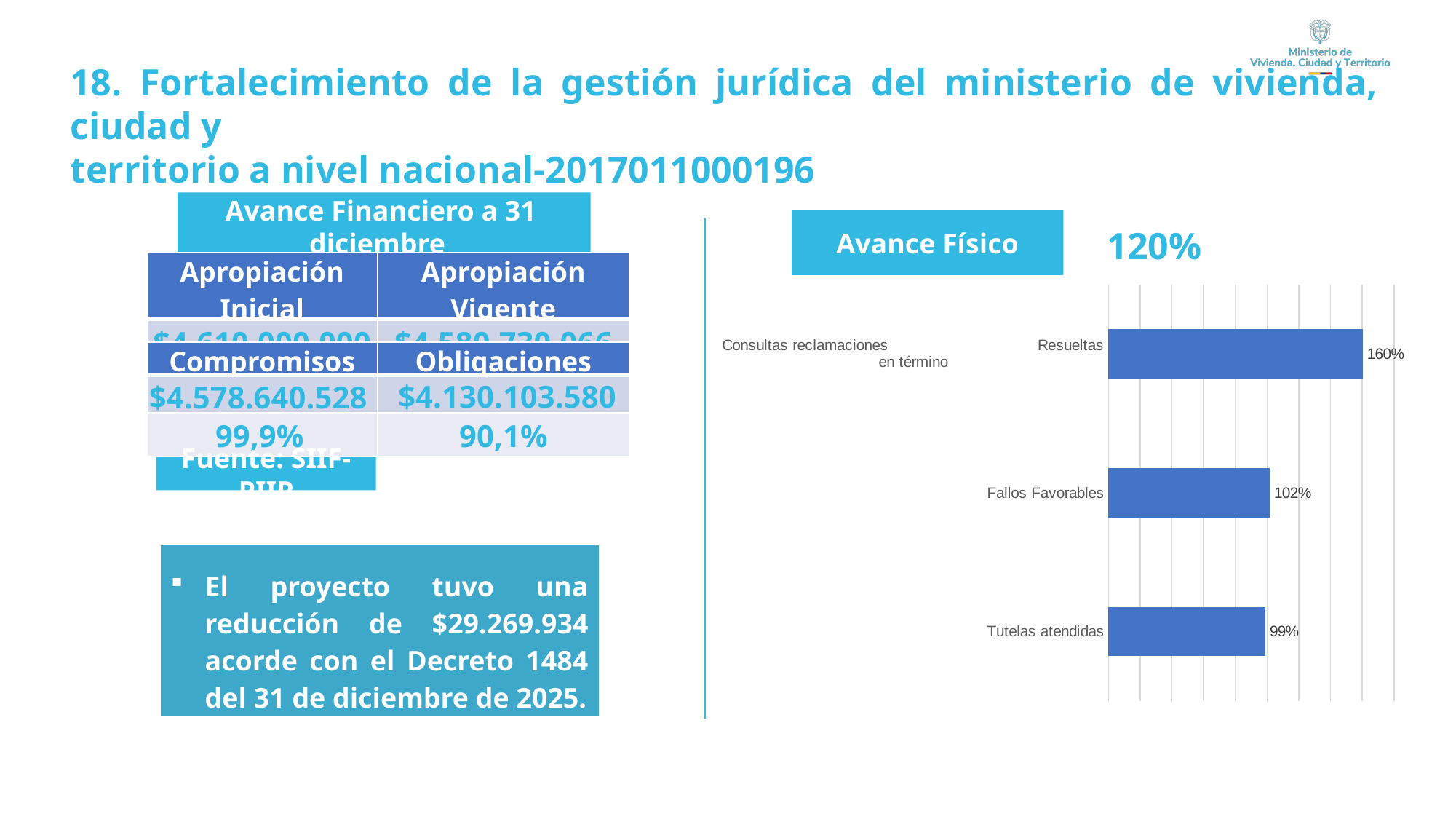
In the "Avance Físico" chart, what is the difference between the values for "Fallos Favorables" and "Tutelas atendidas"? 3% What is the value for "Tutelas atendidas" in the "Avance Físico" chart? 99% What kind of chart is shown under "Avance Físico"? bar chart In the "Avance Físico" chart, which is larger: the value for "Fallos Favorables" or the value for "Tutelas atendidas"? Fallos Favorables What is the value for "Consultas reclamaciones Resueltas en término" in the "Avance Físico" chart? 160% Which category has the highest value in the "Avance Físico" chart? Consultas reclamaciones Resueltas en término How many categories does the "Avance Físico" bar chart show? 3 What colour are the bars in the "Avance Físico" chart? blue Which category has the lowest value in the "Avance Físico" chart? Tutelas atendidas What percentage is displayed next to the "Avance Físico" chart title? 120% In the "Avance Físico" chart, what is the difference between the values for "Consultas reclamaciones Resueltas en término" and "Fallos Favorables"? 58% What is the value for "Fallos Favorables" in the "Avance Físico" chart? 102%